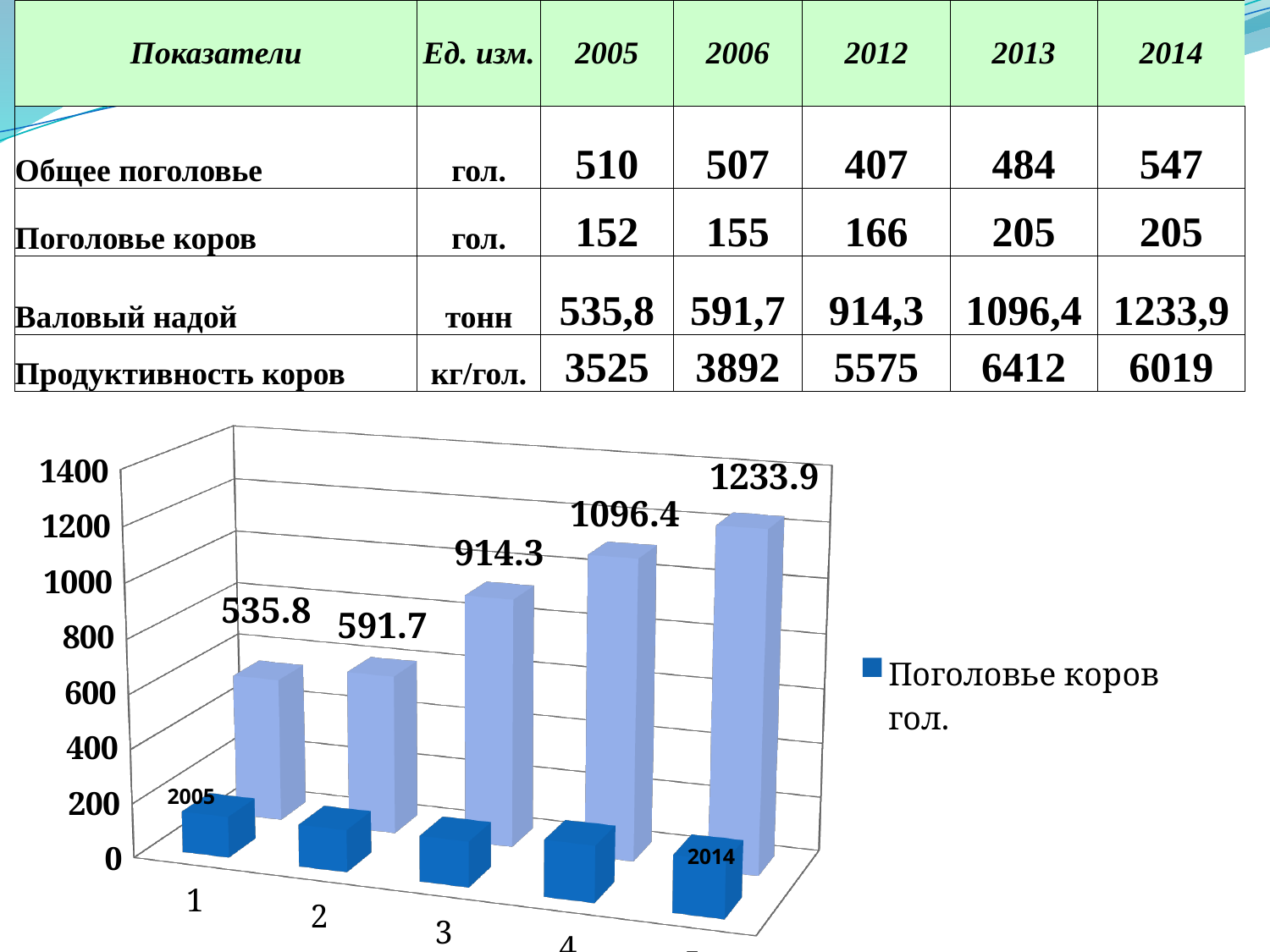
What is the data label on the light blue bar for category 1? 535.8 What is the difference between the light blue bar values for category 4 and category 3? 182.1 What is the data label on the light blue bar for category 3? 914.3 How many entries does the chart legend list? 1 What type of chart is shown on the slide? bar chart What text is shown in the chart legend? Поголовье коров гол. Do the light blue bars rise or fall from category 1 to category 5? rise Which is larger, the light blue bar for category 2 or for category 3? category 3 What is the data label on the light blue bar for category 4? 1096.4 What is the difference between the light blue bar values for category 5 and category 1? 698.1 Which category has the highest light blue bar? 5 Which category has the lowest light blue bar? 1